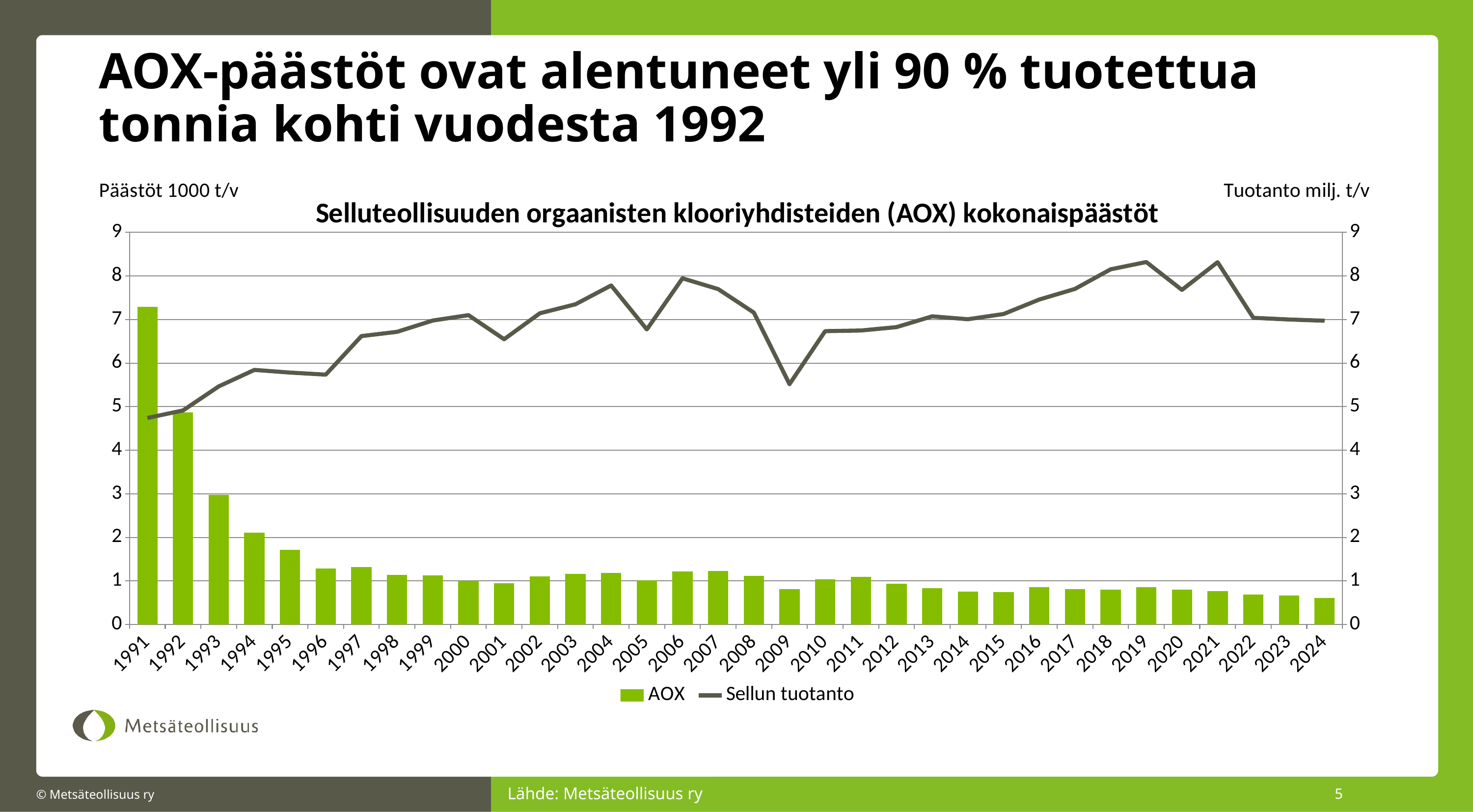
In which year is the Sellun tuotanto line at its lowest? 1991 Is the AOX value for 1995 greater or less than 2? less How many series does the legend list? 2 Which year has the larger AOX value, 1991 or 1992? 1991 In which year is the AOX value highest? 1991 Is the AOX value for 1991 greater or less than 7? greater Is the AOX value for 2024 greater or less than 1? less How many years are shown on the x axis? 34 Do the AOX bars generally rise or fall from 1991 to 2024? Fall What kind of chart is shown on the slide? A combined bar and line chart What are the two entries in the chart legend? AOX and Sellun tuotanto